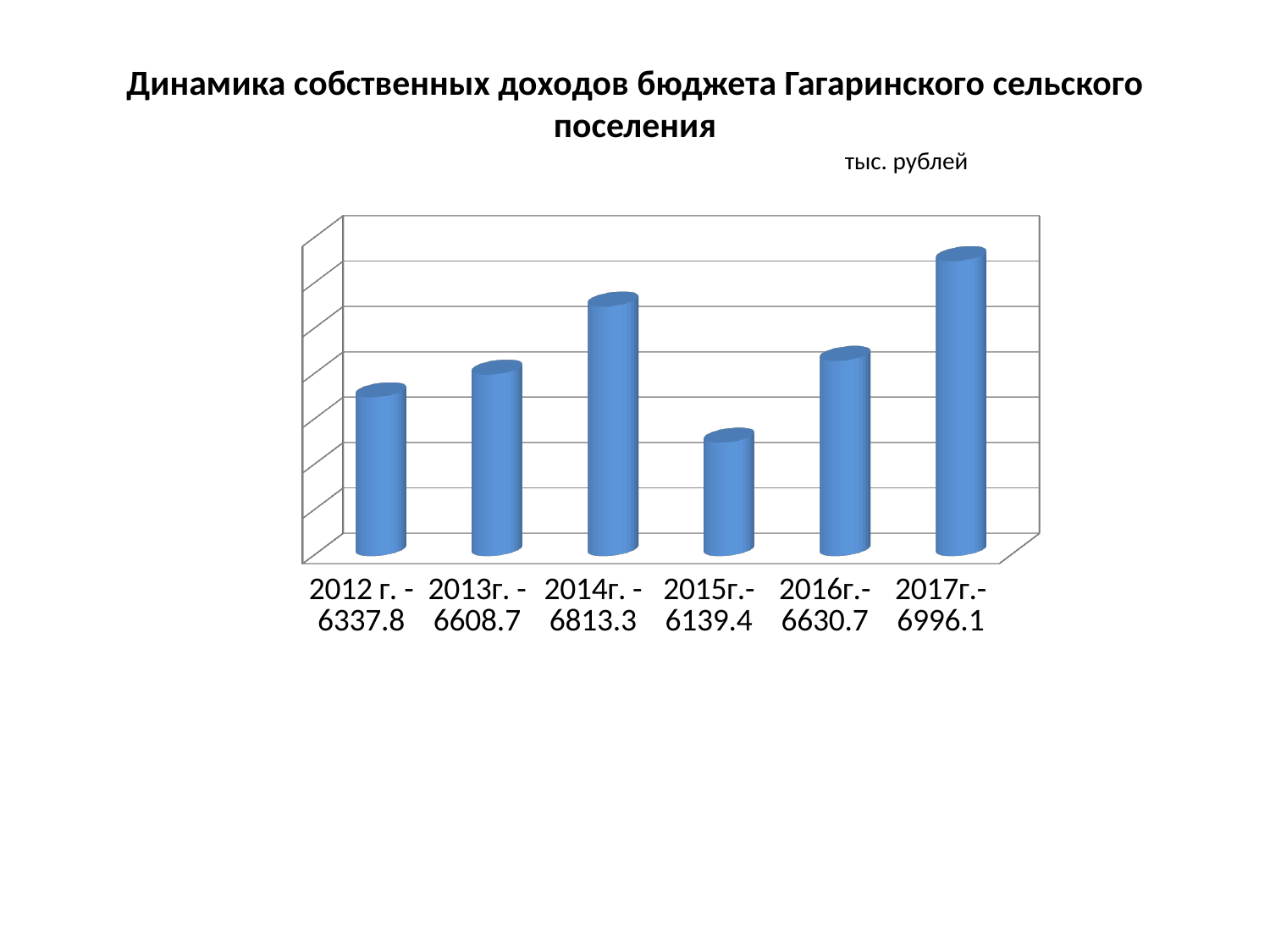
Which year has the larger value, 2014 or 2016? 2014 What was the value of own budget revenues in 2017? 6996.1 What is the difference between the 2014 value and the 2012 value? 475.5 Does the value rise or fall from 2014 to 2015? Fall Which year has the highest own budget revenues? 2017 What was the value of own budget revenues in 2015? 6139.4 What is the difference between the 2017 value and the 2015 value? 856.7 What type of chart is shown on the slide? Bar chart Which year has the lowest own budget revenues? 2015 How many years are shown in the chart? 6 In what units are the values on the chart expressed? тыс. рублей What was the value of own budget revenues in 2014? 6813.3